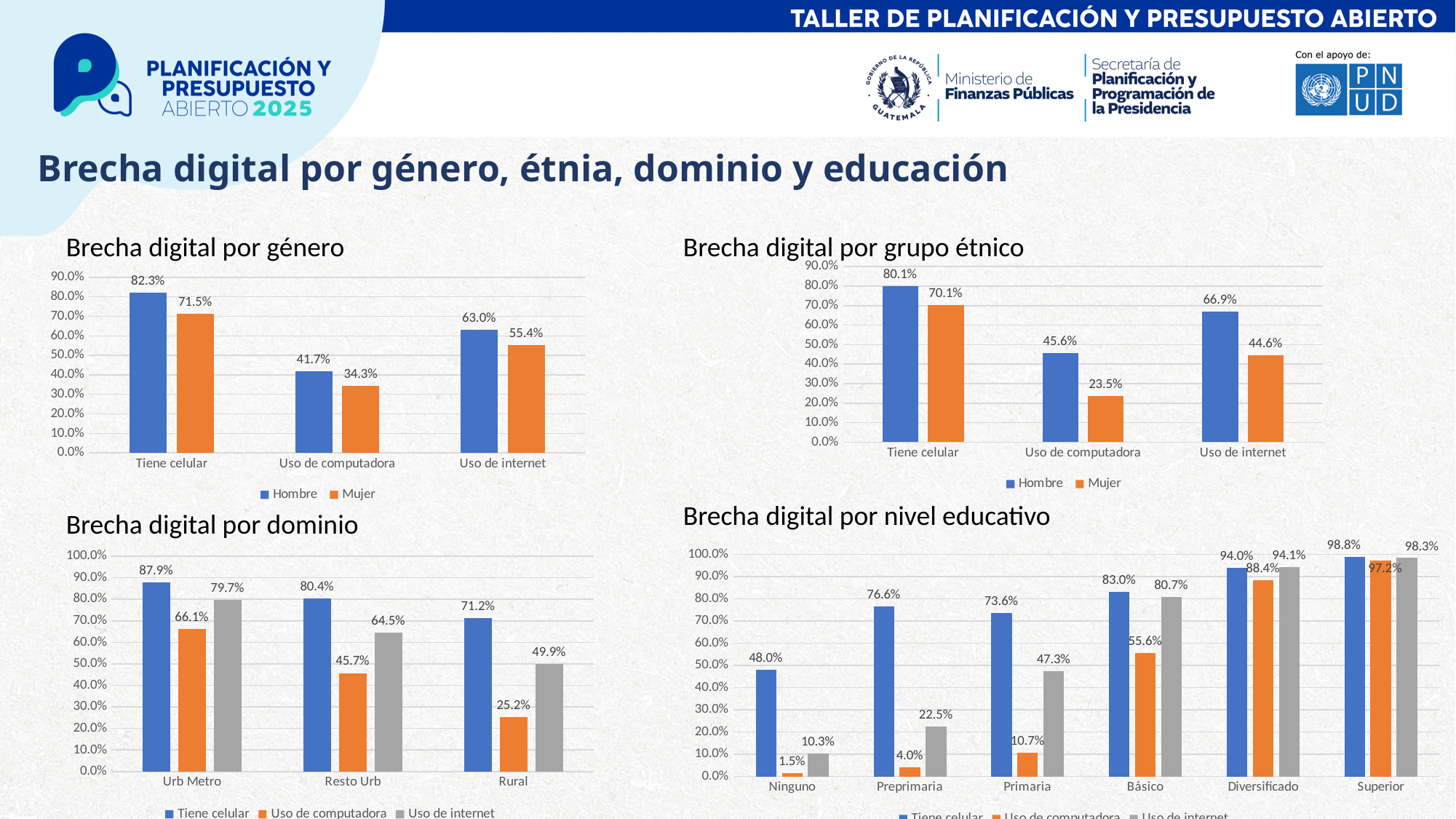
In the 'Brecha digital por dominio' chart, which domain has the highest value for 'Tiene celular'? Urb Metro In the 'Brecha digital por dominio' chart, how many categories are shown on the x axis? 3 What kind of chart is 'Brecha digital por nivel educativo'? bar chart In the 'Brecha digital por nivel educativo' chart, is the value for 'Uso de internet' at Básico larger or smaller than the value for 'Uso de internet' at Primaria? larger In the 'Brecha digital por grupo étnico' chart, which category has the lowest value for Hombre? Uso de computadora In the 'Brecha digital por nivel educativo' chart, what is the value for 'Uso de computadora' at the Ninguno level? 1.5% In the 'Brecha digital por dominio' chart, what is the value for 'Uso de computadora' in Rural? 25.2% In the 'Brecha digital por género' chart, what is the difference between Hombre and Mujer for 'Uso de internet'? 7.6% In the 'Brecha digital por nivel educativo' chart, which education level has the highest value for 'Tiene celular'? Superior In the 'Brecha digital por grupo étnico' chart, what is the value for Mujer in 'Uso de computadora'? 23.5% In the 'Brecha digital por grupo étnico' chart, how many series does the legend list? 2 In the 'Brecha digital por género' chart, what is the value for Hombre in the 'Tiene celular' category? 82.3%